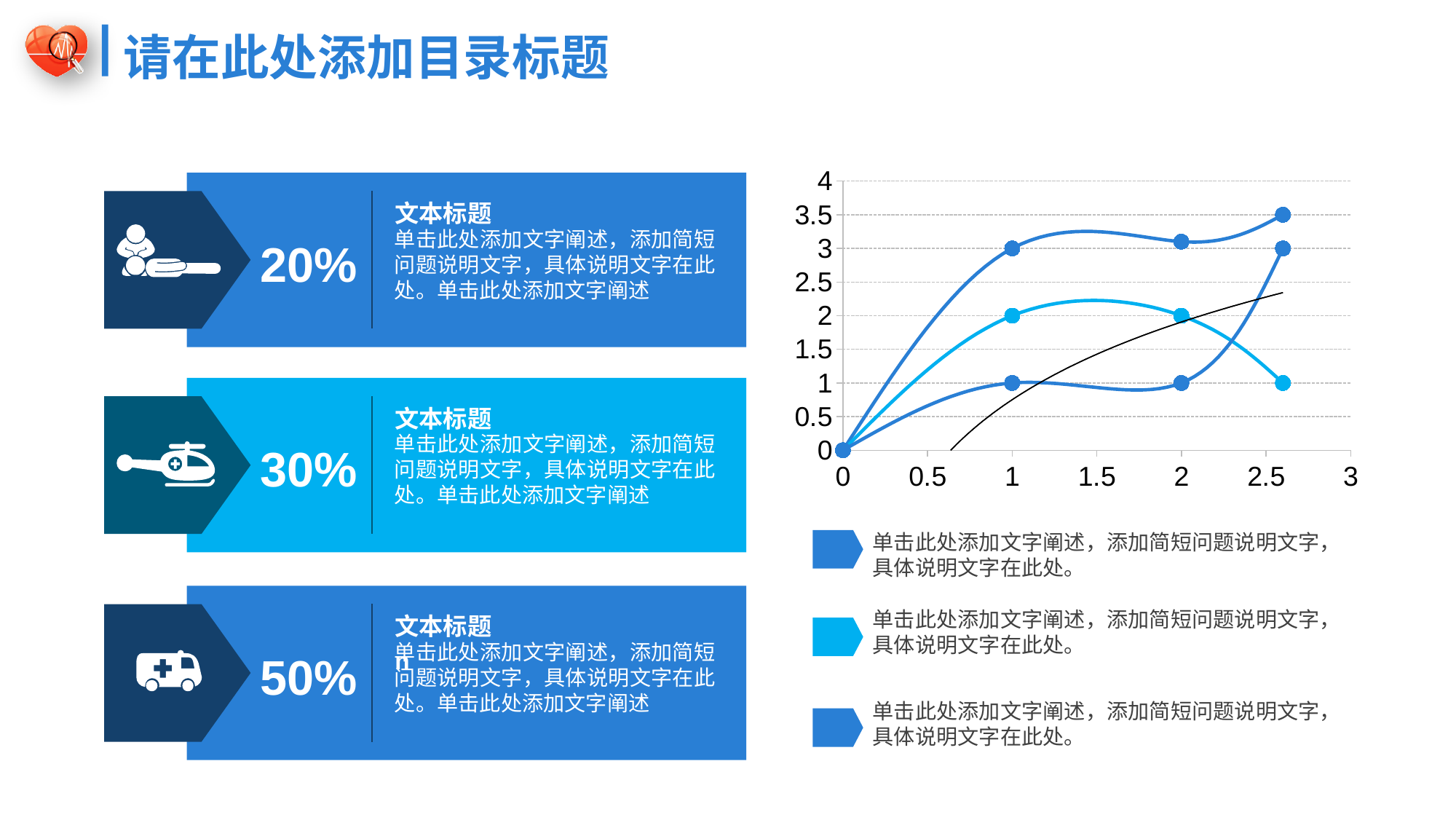
What is the highest tick value shown on the y axis? 4 What is the y value of the light blue line at x = 2? 2 What is the y value of the rightmost point of the light blue line? 1 What is the y value of the light blue line at x = 1? 2 At x = 1, what is the difference between the uppermost line's value and the light blue line's value? 1 What is the y value of the uppermost dark blue line at x = 1? 3 What is the y value of the lowest line at x = 1? 1 What is the highest y value reached by any plotted point on the chart? 3.5 Does the light blue line rise or fall between x = 2 and its last point? fall At x = 2, which is larger: the light blue line's value or the lowest dark blue line's value? the light blue line What kind of chart is shown on the right of the slide? line chart How many coloured data lines are plotted on the chart? 3